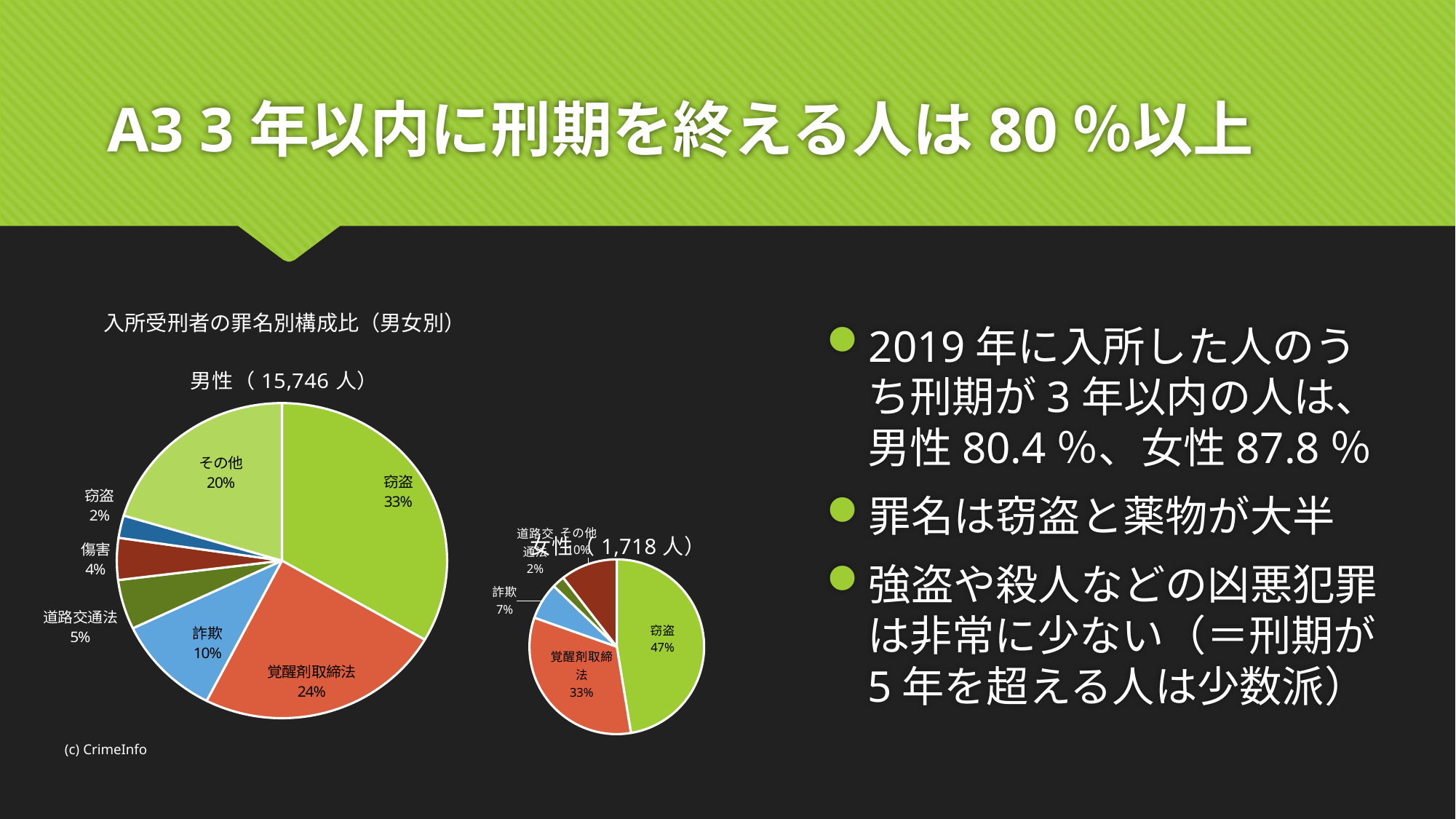
In the 男性 pie chart, what share is 覚醒剤取締法? 24% How many people does the 男性 pie chart cover, according to its label? 15,746 人 In the 男性 pie chart, what share is その他? 20% In the 男性 pie chart, what share is 詐欺? 10% What kind of charts are shown on the slide? Pie charts In the 男性 pie chart, which category has the largest slice? 窃盗 In the 男性 pie chart, what is the difference in percentage points between 窃盗 and 覚醒剤取締法? 9 percentage points Which chart shows a larger share for 窃盗, the 男性 chart or the 女性 chart? 女性